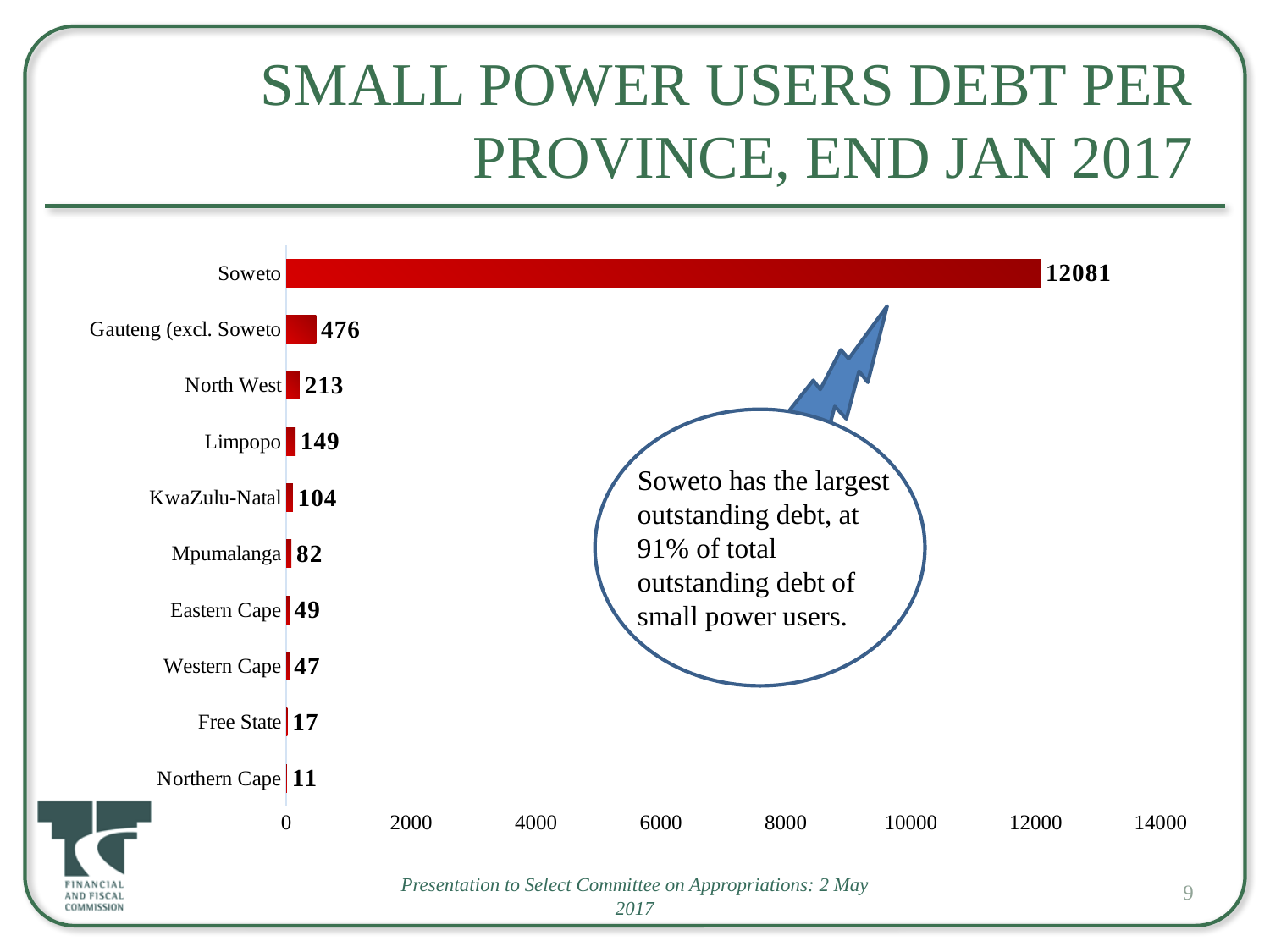
What is the small power users debt value shown for Soweto? 12081 What is the value shown for KwaZulu-Natal? 104 What type of chart is shown on the slide? Bar chart What is the difference between the values for North West and Limpopo? 64 Is the value for Soweto greater or less than 10000? greater Which has a larger value, Mpumalanga or Eastern Cape? Mpumalanga Which province has the lowest small power users debt? Northern Cape What is the difference between the values for Western Cape and Free State? 30 Which province has the highest small power users debt? Soweto What is the value shown for Free State? 17 What is the value shown for Gauteng (excl. Soweto)? 476 How many provinces/categories are shown in the chart? 10